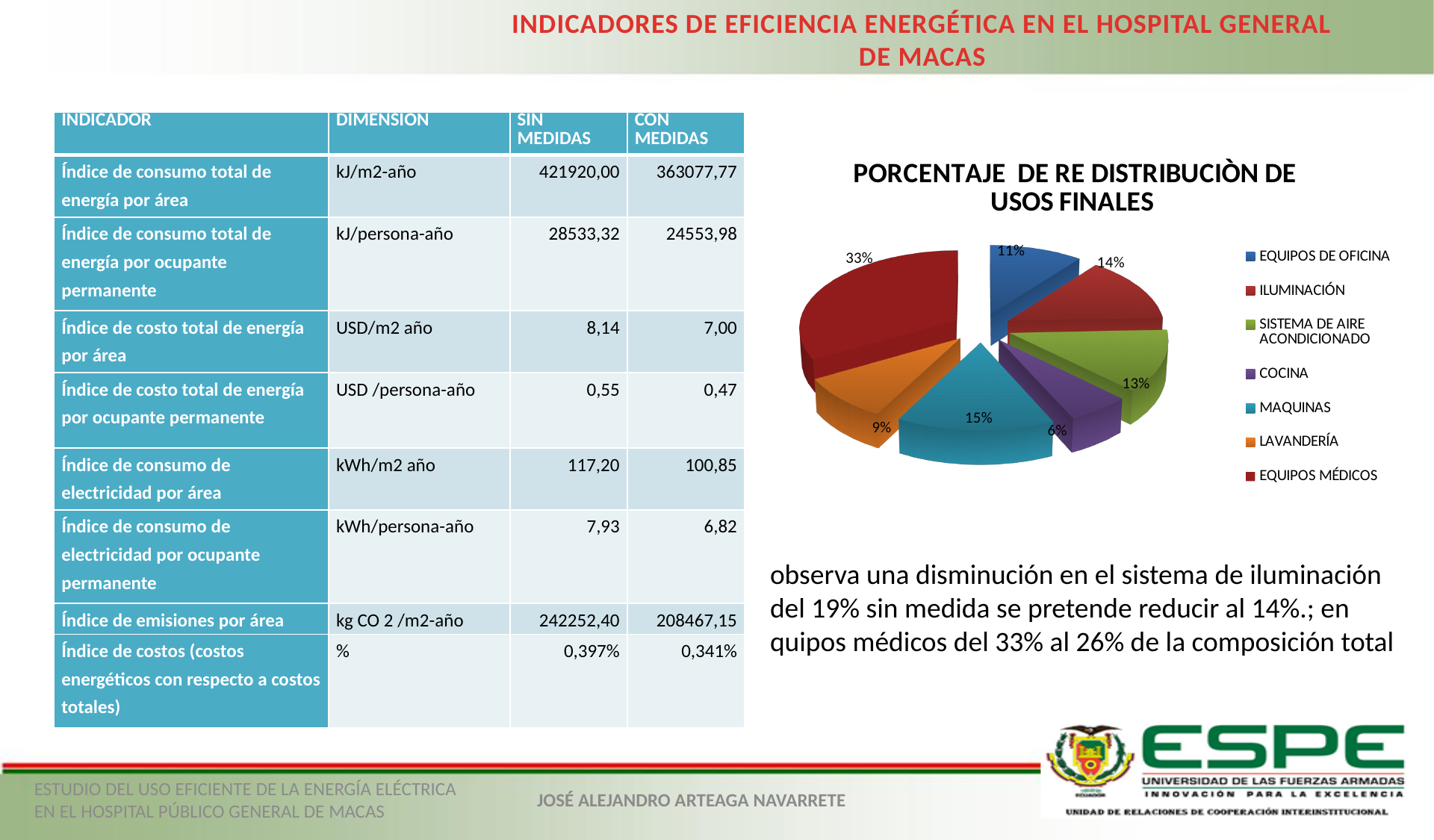
Which category has the largest share of the pie chart? EQUIPOS MÉDICOS What percentage of the pie chart corresponds to EQUIPOS MÉDICOS? 33% What percentage of the pie chart corresponds to COCINA? 6% What percentage of the pie chart corresponds to MAQUINAS? 15% What is the difference in percentage points between EQUIPOS MÉDICOS and MAQUINAS in the pie chart? 18 Which has a larger share in the pie chart, SISTEMA DE AIRE ACONDICIONADO or EQUIPOS DE OFICINA? SISTEMA DE AIRE ACONDICIONADO What percentage of the pie chart corresponds to ILUMINACIÓN? 14% How many categories does the pie chart legend list? 7 What percentage of the pie chart corresponds to LAVANDERÍA? 9% What kind of chart is shown on the slide? pie chart Which category has the smallest share of the pie chart? COCINA What is the title of the pie chart? PORCENTAJE DE RE DISTRIBUCIÒN DE USOS FINALES